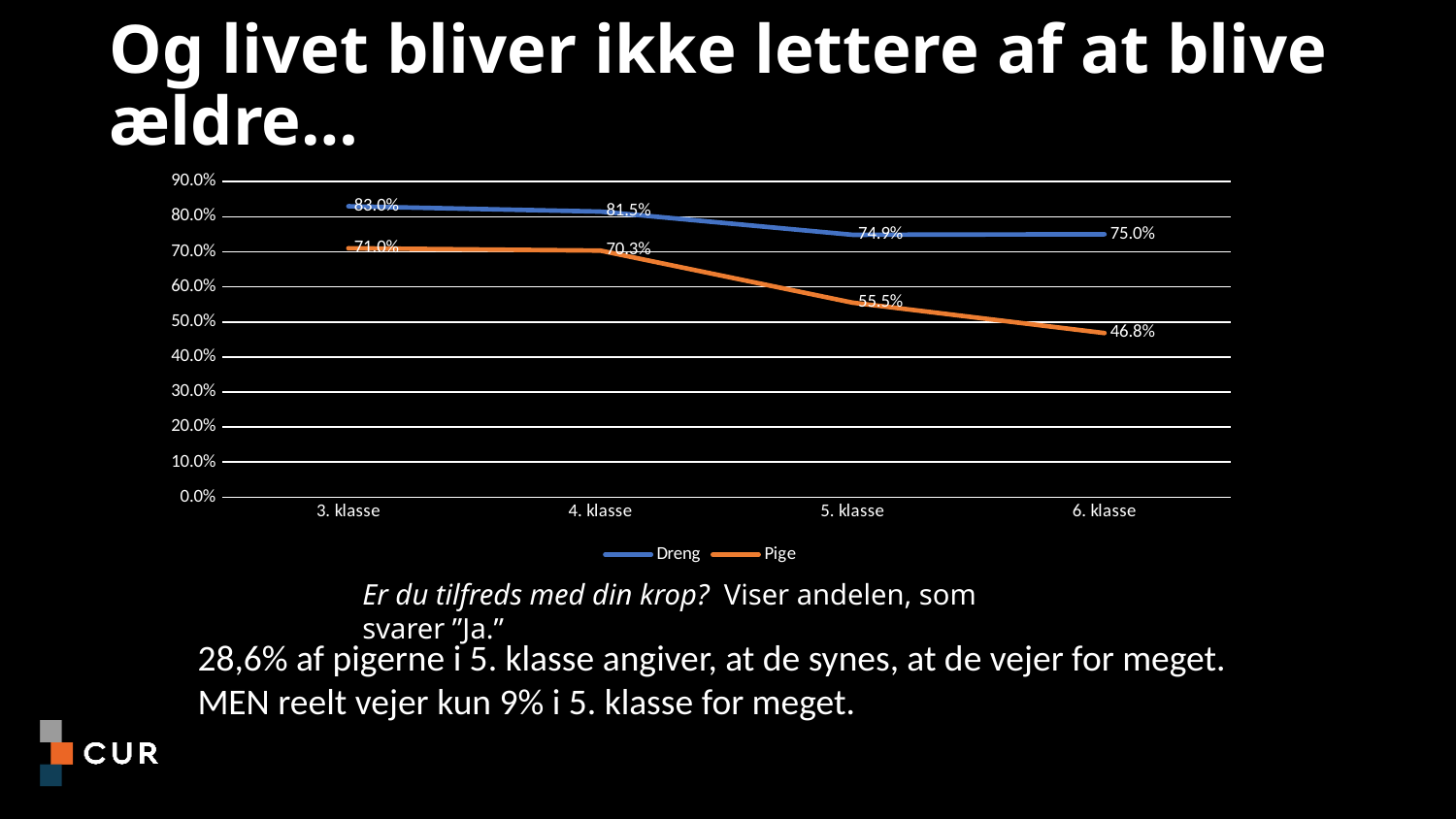
What is the value for Pige in 6. klasse? 46.8% Which is larger in 5. klasse, the value for Dreng or the value for Pige? Dreng What is the value for Dreng in 4. klasse? 81.5% What kind of chart is shown on the slide? Line chart In which class is the value for Pige lowest? 6. klasse How many series does the legend list? 2 What is the difference between the Pige values in 3. klasse and 6. klasse? 24.2% What is the difference between the Dreng and Pige values in 6. klasse? 28.2% What is the value for Dreng in 3. klasse? 83.0% What is the value for Pige in 5. klasse? 55.5% How many classes are shown on the x axis? 4 In which class is the value for Dreng highest? 3. klasse